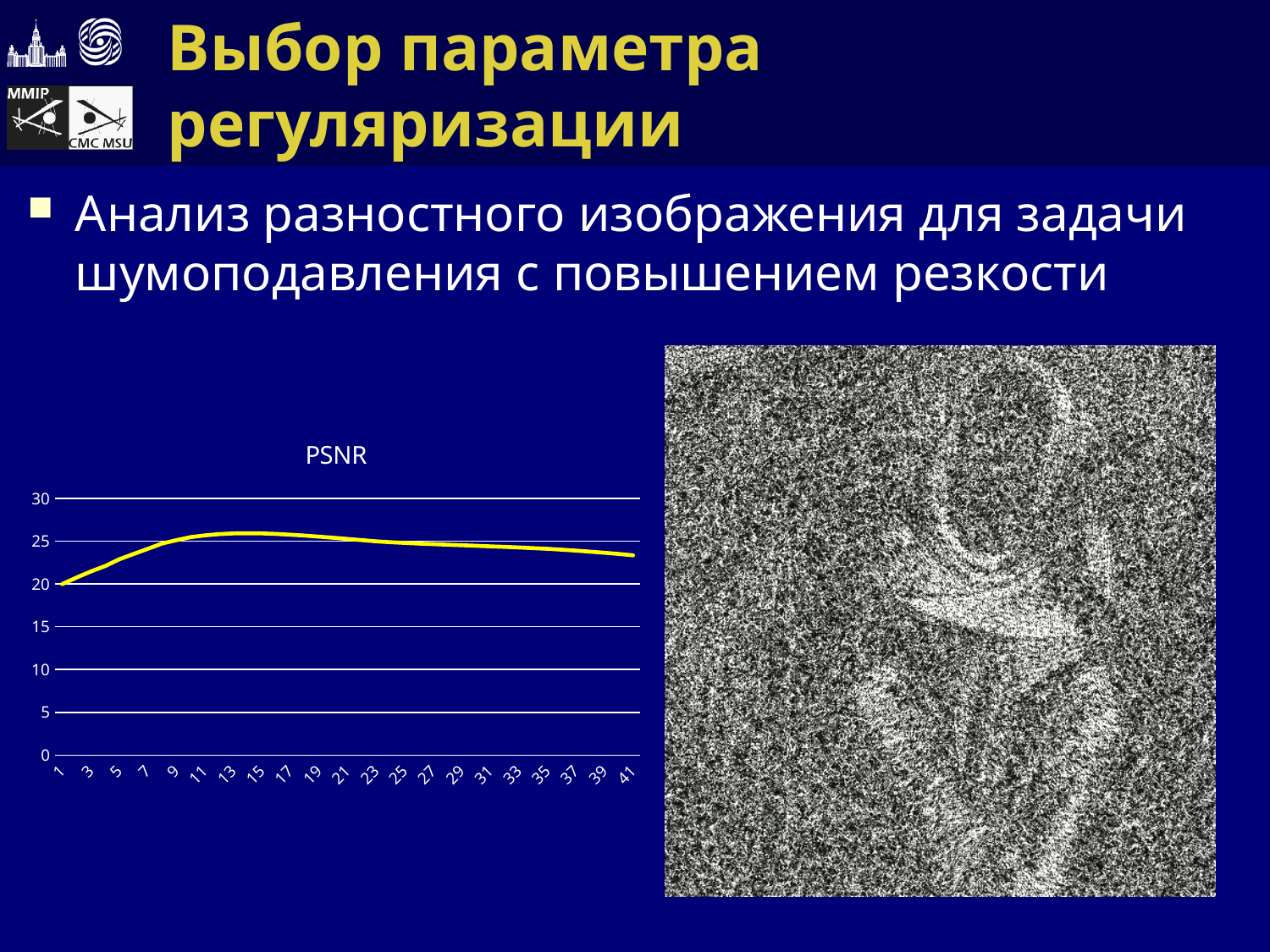
What kind of chart is shown on the slide? line chart Is the PSNR value at x = 41 greater or less than 20? greater Does the PSNR line rise or fall between x = 1 and x = 13? rise Is the PSNR value at x = 15 greater or less than 25? greater Is the PSNR value at x = 1 greater or less than 25? less What is the title of the chart on the slide? PSNR How many lines (series) are plotted on the PSNR chart? 1 What is the highest value shown on the y axis of the PSNR chart? 30 Does the PSNR line rise or fall between x = 17 and x = 41? fall How many tick labels are shown on the x axis of the PSNR chart? 21